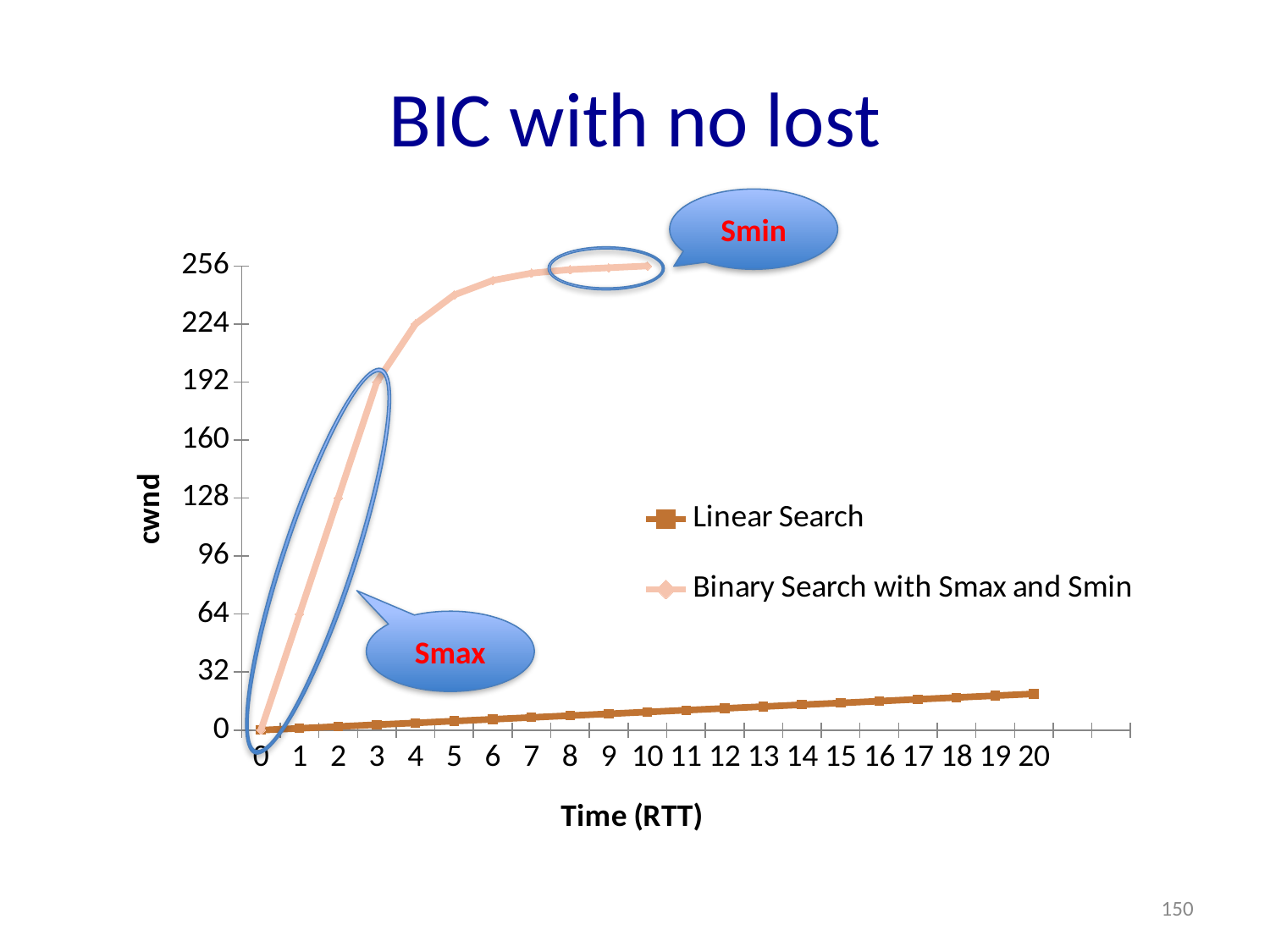
What kind of chart is shown on the slide? line chart Does the cwnd value of the Linear Search series rise or fall as time increases? rise What is the title of the chart on the slide? BIC with no lost What is the cwnd value of the Binary Search with Smax and Smin series at time 1? 64 What is the cwnd value of the Binary Search with Smax and Smin series at time 2? 128 Is the cwnd value of the Binary Search with Smax and Smin series at time 8 greater or less than 224? greater How many time values are labelled on the x axis? 21 At time 10, which series has the larger cwnd value, Linear Search or Binary Search with Smax and Smin? Binary Search with Smax and Smin How many series does the legend list? 2 What is the cwnd value of the Binary Search with Smax and Smin series at time 3? 192 What is the label of the x axis? Time (RTT) Is the cwnd value of the Linear Search series at time 20 greater or less than 32? less